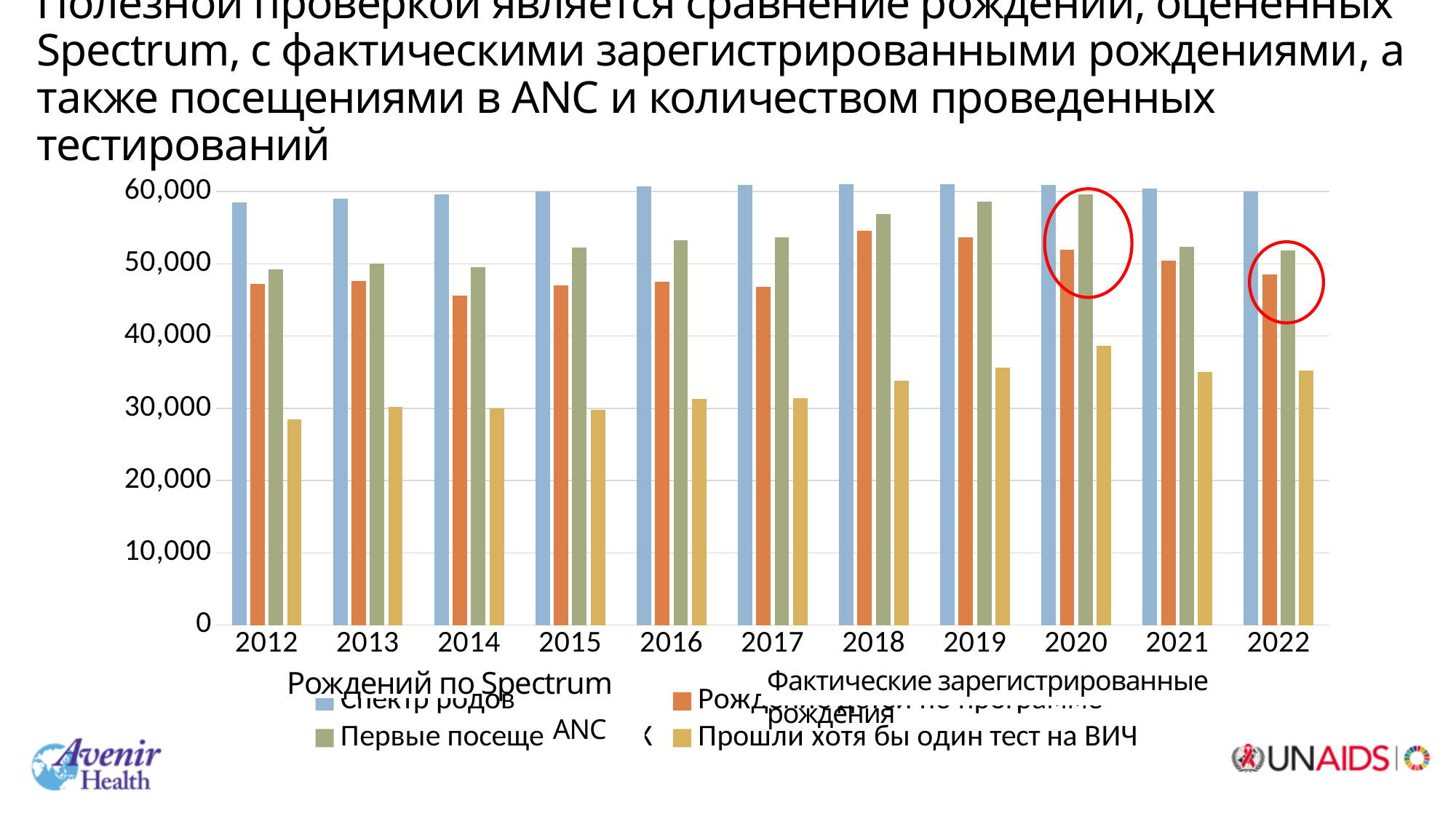
How many years are shown on the x axis of the chart? 11 Is the value for 'Рождений по Spectrum' in 2012 greater or less than 50,000? greater Is the value for 'Фактические зарегистрированные рождения' in 2014 greater or less than 50,000? less In 2020, which is larger: the first ANC visits (green) bar or the 'Фактические зарегистрированные рождения' (orange) bar? first ANC visits (green) What kind of chart is shown on the slide? bar chart How many series does the chart's legend list? 4 Is the value for 'Фактические зарегистрированные рождения' in 2018 greater or less than 50,000? greater Which years on the chart are circled in red? 2020 and 2022 In which year is the value for 'Прошли хотя бы один тест на ВИЧ' highest? 2020 Does the value for 'Прошли хотя бы один тест на ВИЧ' generally rise or fall from 2012 to 2022? rise